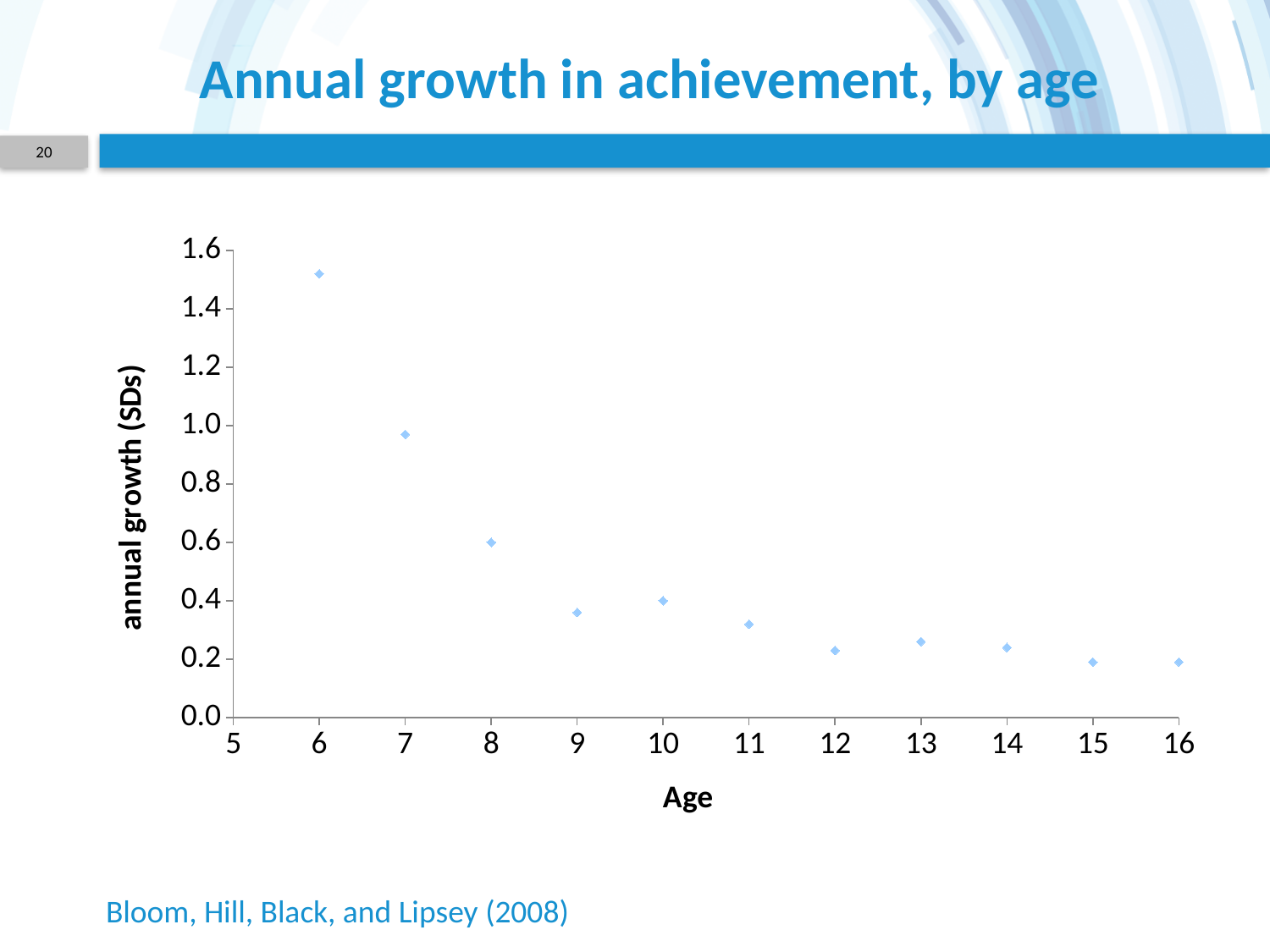
What is the label on the y axis of the chart? annual growth (SDs) Is the annual growth value for age 7 greater or less than 0.8? greater At which age is annual growth in achievement highest? 6 Is the annual growth value for age 16 greater or less than 0.4? less Do the values generally rise or fall as age increases along the x axis? fall Is the annual growth value for age 8 greater or less than 0.8? less How many data points are plotted in the chart? 11 Which has the larger annual growth value, age 6 or age 7? age 6 Which has the larger annual growth value, age 8 or age 12? age 8 What kind of chart is shown on the slide? scatter plot